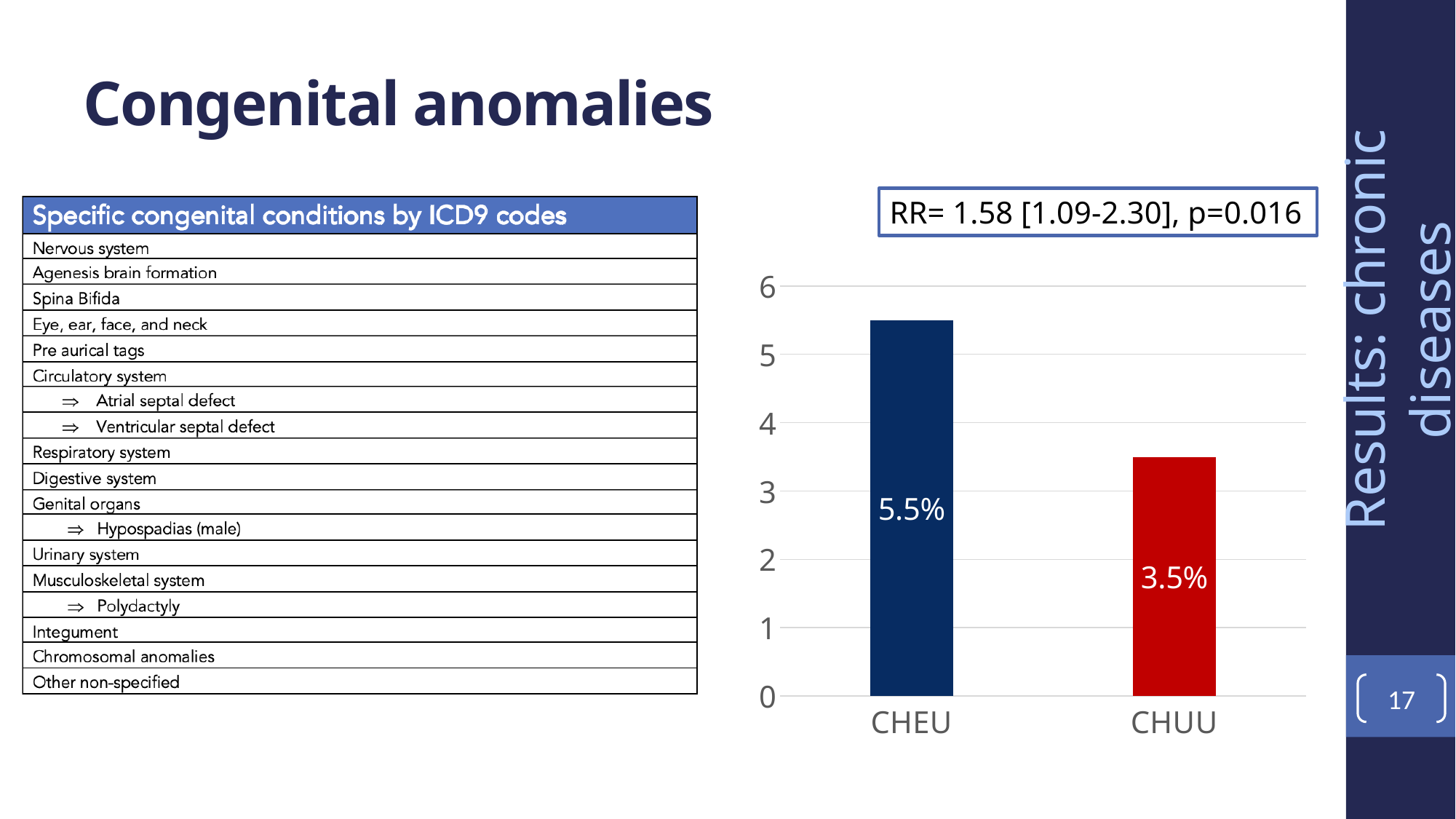
Which category has the highest value? CHEU How many categories are shown on the x axis of the chart? 2 What is the difference between the values for CHEU and CHUU? 2.0% What is the value for CHEU? 5.5% Which category has the lowest value? CHUU Is the value for CHUU greater or less than 4? less Is the value for CHEU greater or less than 5? greater What colour is the bar for CHUU? red Which is larger, the value for CHEU or the value for CHUU? CHEU What kind of chart is shown on the slide? bar chart What is the value for CHUU? 3.5% What relative risk (RR) is stated in the box above the chart? RR= 1.58 [1.09-2.30], p=0.016